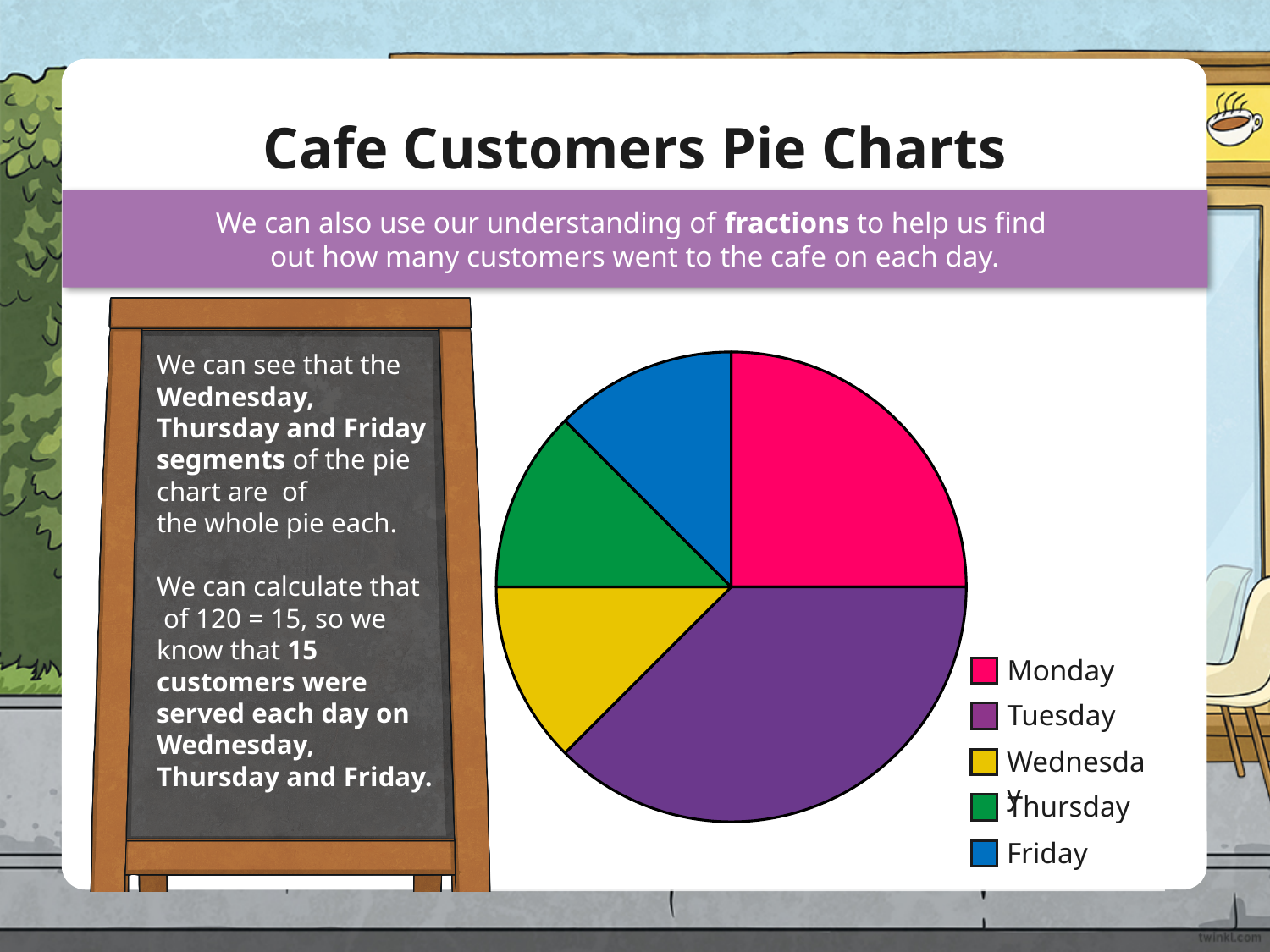
Which slice is larger, Monday or Wednesday? Monday How many entries does the legend of the pie chart list? 5 Which slice is larger, Tuesday or Friday? Tuesday According to the slide, how many customers were served on Friday? 15 What kind of chart is shown on the slide? pie chart How many slices does the pie chart have? 5 Which slice is larger, Tuesday or Monday? Tuesday Which day is shown in green in the pie chart legend? Thursday According to the slide, how many customers were served on Wednesday? 15 What is the total number of customers the pie chart represents, according to the slide text? 120 What colour is the Monday slice in the pie chart? pink Which day has the largest slice of the pie chart? Tuesday